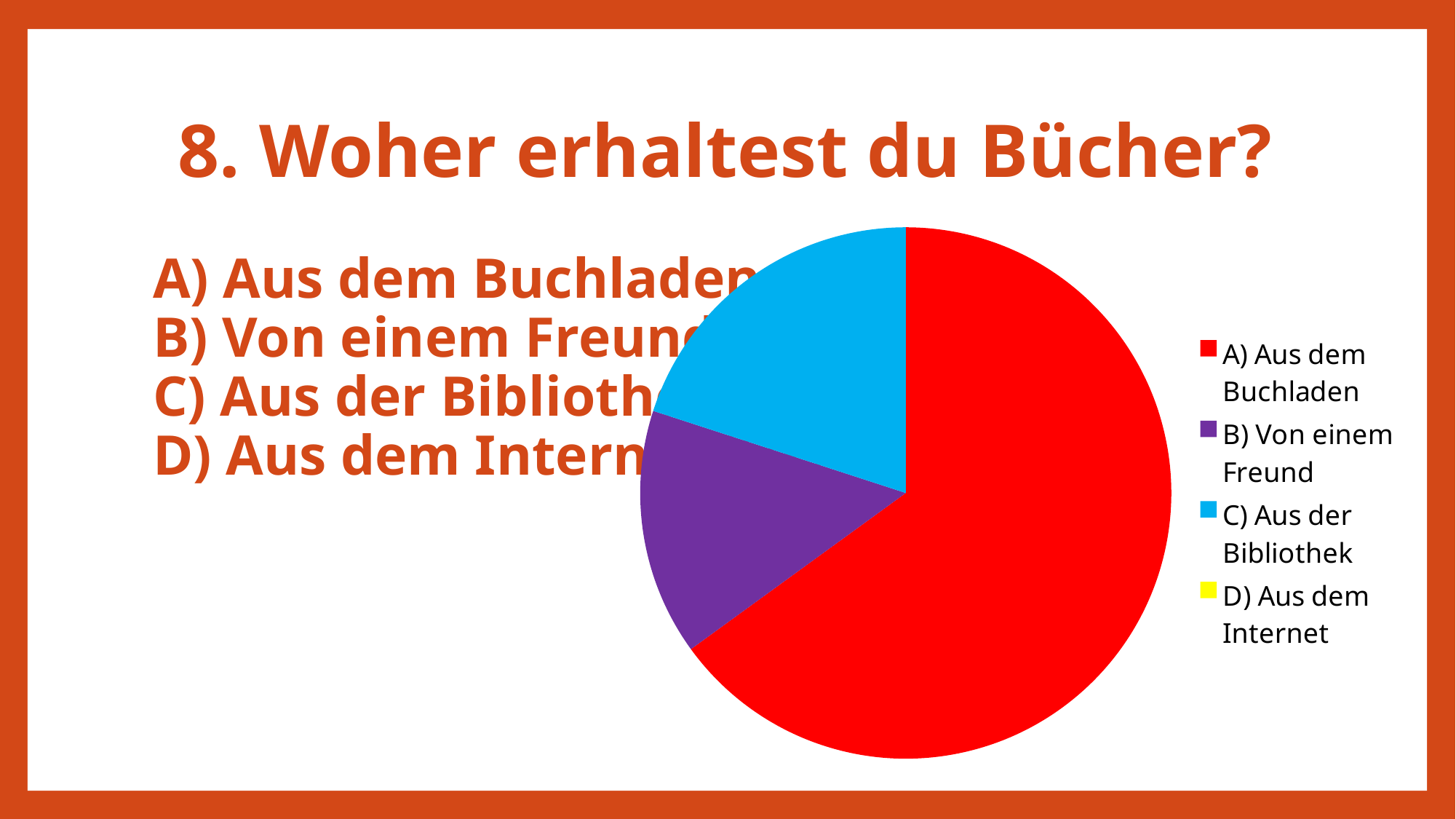
Which slice is larger: A) Aus dem Buchladen or C) Aus der Bibliothek? A) Aus dem Buchladen Which category has the smallest share of the pie chart? D) Aus dem Internet Which category is shown in blue in the pie chart? C) Aus der Bibliothek What kind of chart is shown on the slide? pie chart What colour represents A) Aus dem Buchladen in the pie chart? red Which slice is larger: A) Aus dem Buchladen or B) Von einem Freund? A) Aus dem Buchladen How many categories does the legend of the pie chart list? 4 Which category has the largest slice of the pie chart? A) Aus dem Buchladen Which slice is larger: B) Von einem Freund or C) Aus der Bibliothek? C) Aus der Bibliothek